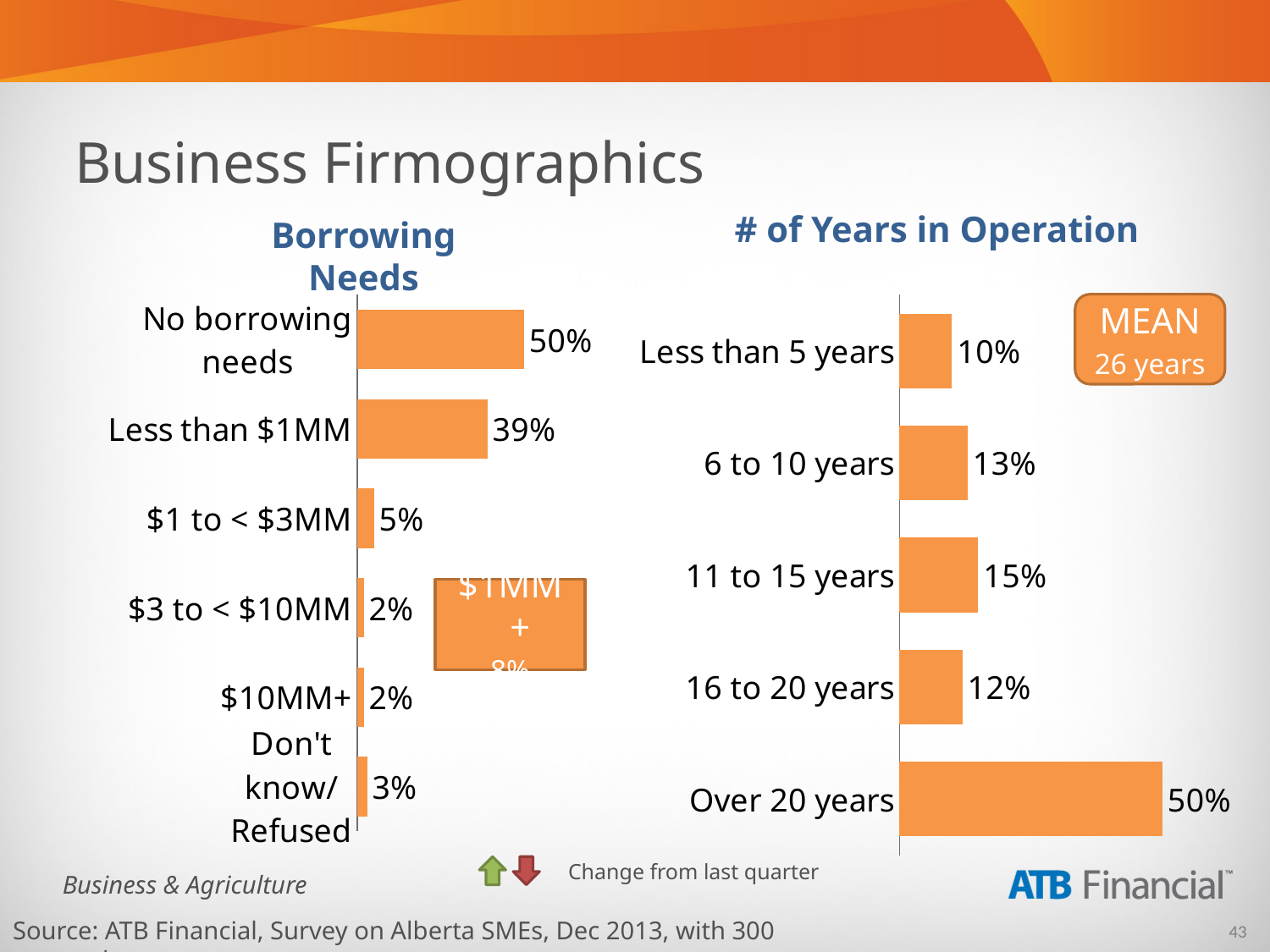
In the # of Years in Operation chart, what is the value for 11 to 15 years? 15% In the # of Years in Operation chart, which category has the lowest value? Less than 5 years In the Borrowing Needs chart, what is the value for Less than $1MM? 39% In the # of Years in Operation chart, which is larger: 6 to 10 years or 16 to 20 years? 6 to 10 years In the # of Years in Operation chart, what is the value for Less than 5 years? 10% In the # of Years in Operation chart, which category has the highest value? Over 20 years In the Borrowing Needs chart, how many categories are shown? 6 What type of chart is the # of Years in Operation chart? Bar chart In the Borrowing Needs chart, what percentage of businesses have no borrowing needs? 50% In the # of Years in Operation chart, how many categories are shown? 5 In the Borrowing Needs chart, what is the value for Don't know/Refused? 3% In the Borrowing Needs chart, what is the difference between No borrowing needs and Less than $1MM? 11%